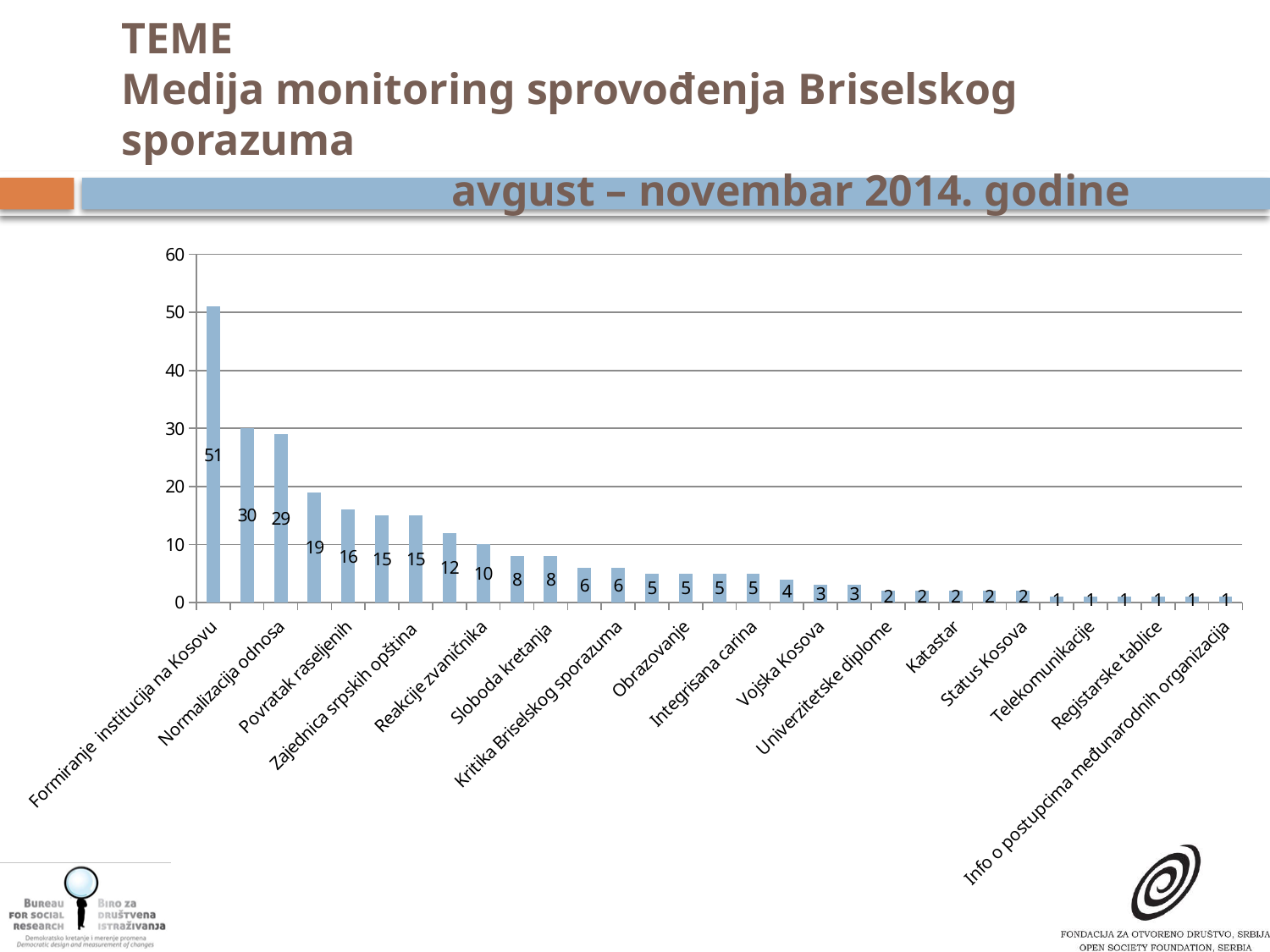
What is the difference between the values for Formiranje institucija na Kosovu and Normalizacija odnosa? 22 What is the value for Zajednica srpskih opština? 15 What kind of chart is shown on the slide? bar chart What is the value for Reakcije zvaničnika? 10 What is the value for Povratak raseljenih? 16 Which category has the highest value? Formiranje institucija na Kosovu What is the value for Vojska Kosova? 3 Do the values rise or fall from left to right along the x axis? fall Is the value for Formiranje institucija na Kosovu greater or less than 50? greater What is the value for Formiranje institucija na Kosovu? 51 Which is larger, the value for Povratak raseljenih or the value for Sloboda kretanja? Povratak raseljenih What period does the chart cover, according to the subtitle? avgust – novembar 2014. godine